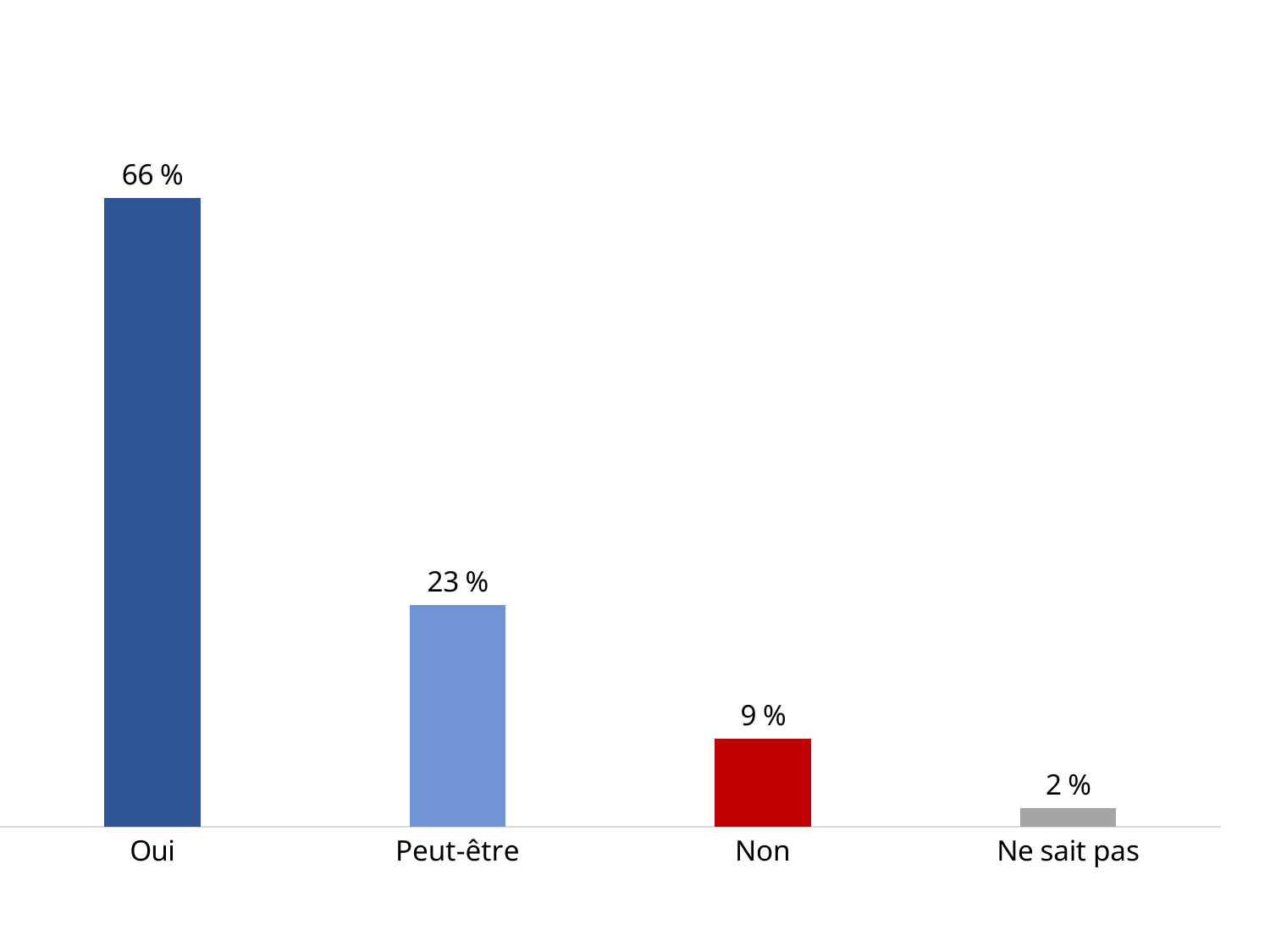
How many categories are shown on the chart? 4 Do the values rise or fall from left to right along the x axis? Fall Which is larger, the value for Peut-être or the value for Non? Peut-être What is the value for Ne sait pas? 2 % Which category has the highest value? Oui What kind of chart is this? Bar chart Which category has the lowest value? Ne sait pas What is the value for Peut-être? 23 % What is the difference between the values for Oui and Peut-être? 43 % What is the value for Oui? 66 % What is the value for Non? 9 % What is the difference between the values for Non and Ne sait pas? 7 %